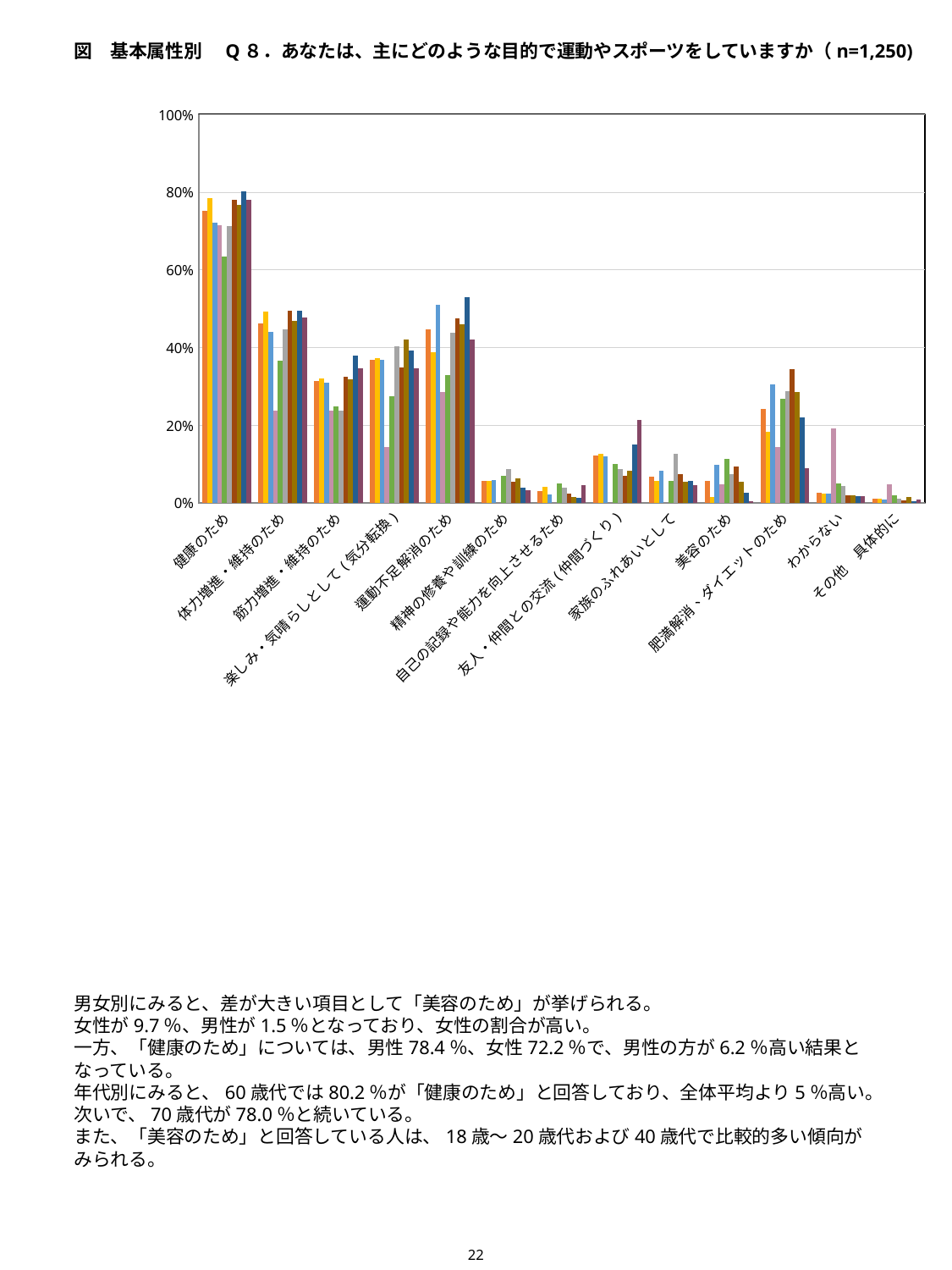
What kind of chart is shown on the slide? bar chart Are all the bars for わからない greater or less than 40%? less Are all the bars for 健康のため greater or less than 60%? greater Which category has taller bars overall, 肥満解消、ダイエットのため or 美容のため? 肥満解消、ダイエットのため Is the tallest bar for 運動不足解消のため greater or less than 40%? greater Which category has the tallest bars in the chart? 健康のため What is the interval between the tick marks on the y axis? 20% What is the maximum value shown on the y axis of the chart? 100% Which category has taller bars overall, 体力増進・維持のため or 筋力増進・維持のため? 体力増進・維持のため How many categories are shown along the x axis of the chart? 13